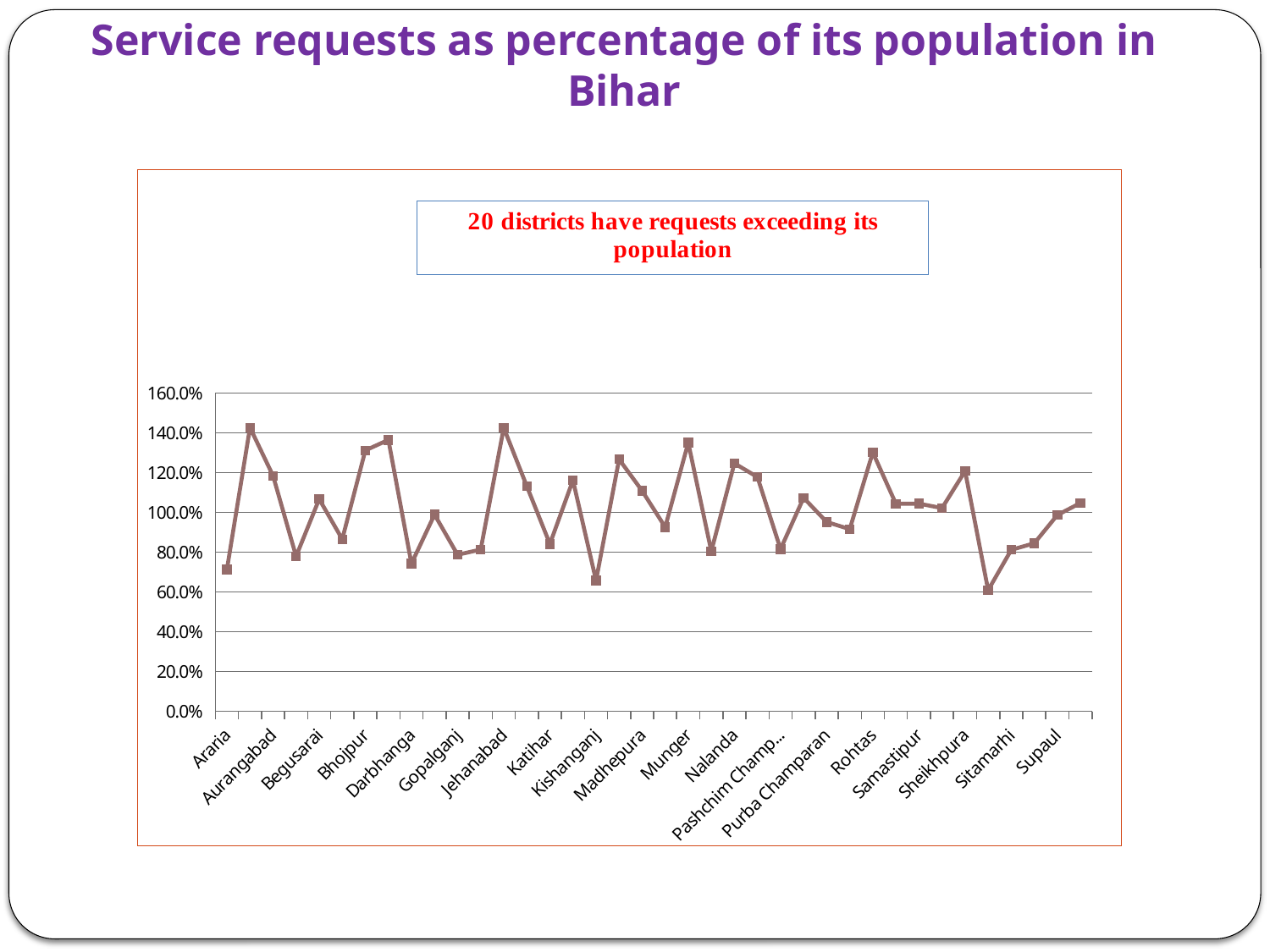
According to the text box on the chart, how many districts have requests exceeding their population? 20 Does the value rise or fall from Araria to Aurangabad? rise What is the title of the chart on the slide? Service requests as percentage of its population in Bihar Is the value for Rohtas greater or less than 120.0%? greater Which has the larger value, Munger or Araria? Munger Is the value for Darbhanga greater or less than 80.0%? less Is the value for Munger greater or less than 120.0%? greater What kind of chart is shown on the slide? line chart Which has the larger value, Kishanganj or Madhepura? Madhepura